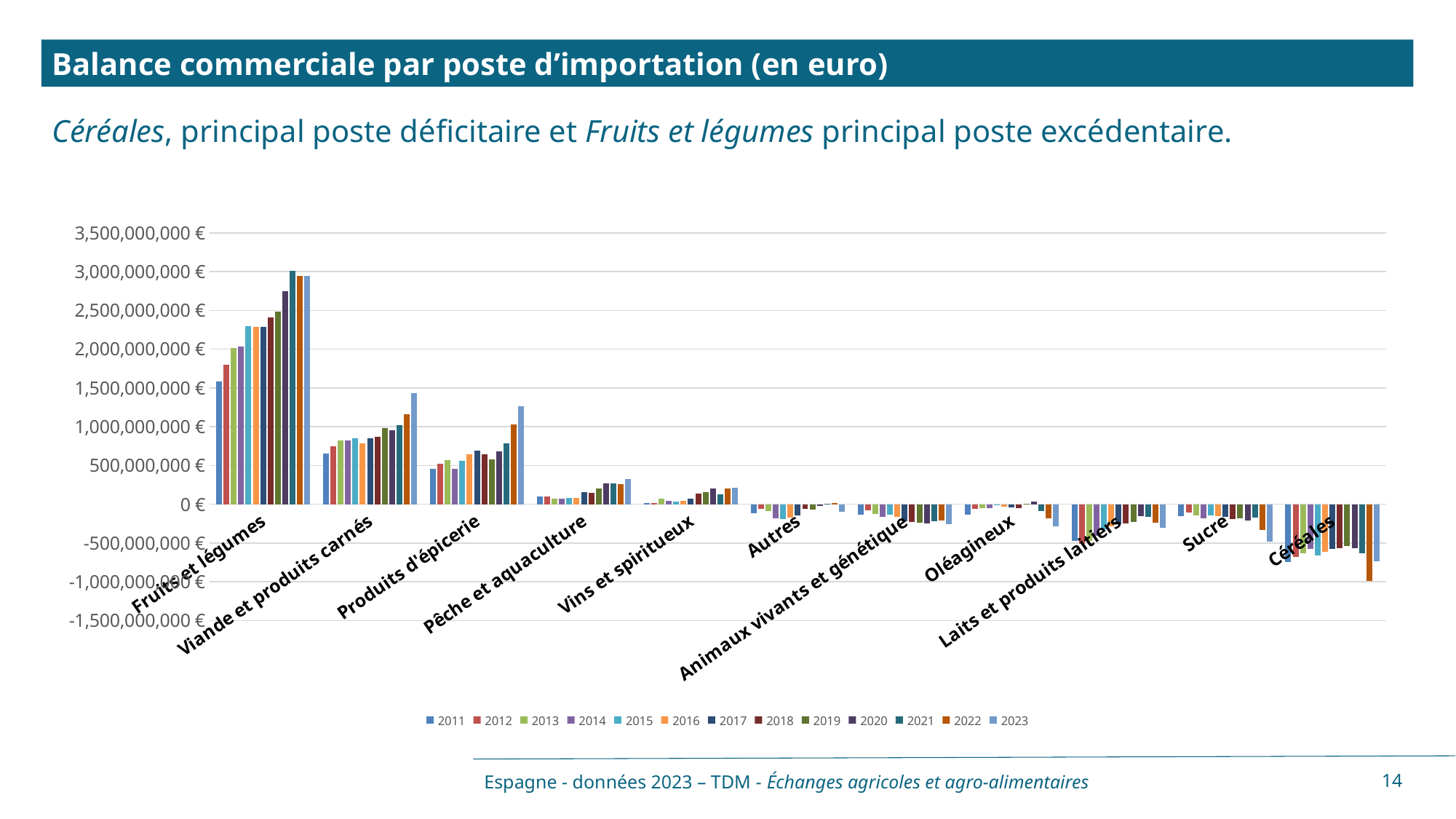
How many import categories are shown on the x axis? 11 Which is larger in 2023: the value for Fruits et légumes or the value for Produits d'épicerie? Fruits et légumes Which category has the lowest (most negative) trade balance values? Céréales Is the value for Fruits et légumes in 2023 greater or less than 2,500,000,000 €? greater What kind of chart is shown on the slide? bar chart Is the value for Céréales in 2022 greater or less than -500,000,000 €? less Do the values for Fruits et légumes generally rise or fall from 2011 to 2023? rise Is the value for Pêche et aquaculture in 2023 greater or less than 500,000,000 €? less What is the title of the chart? Balance commerciale par poste d’importation (en euro) Which category has the highest trade balance values? Fruits et légumes How many series does the legend list? 13